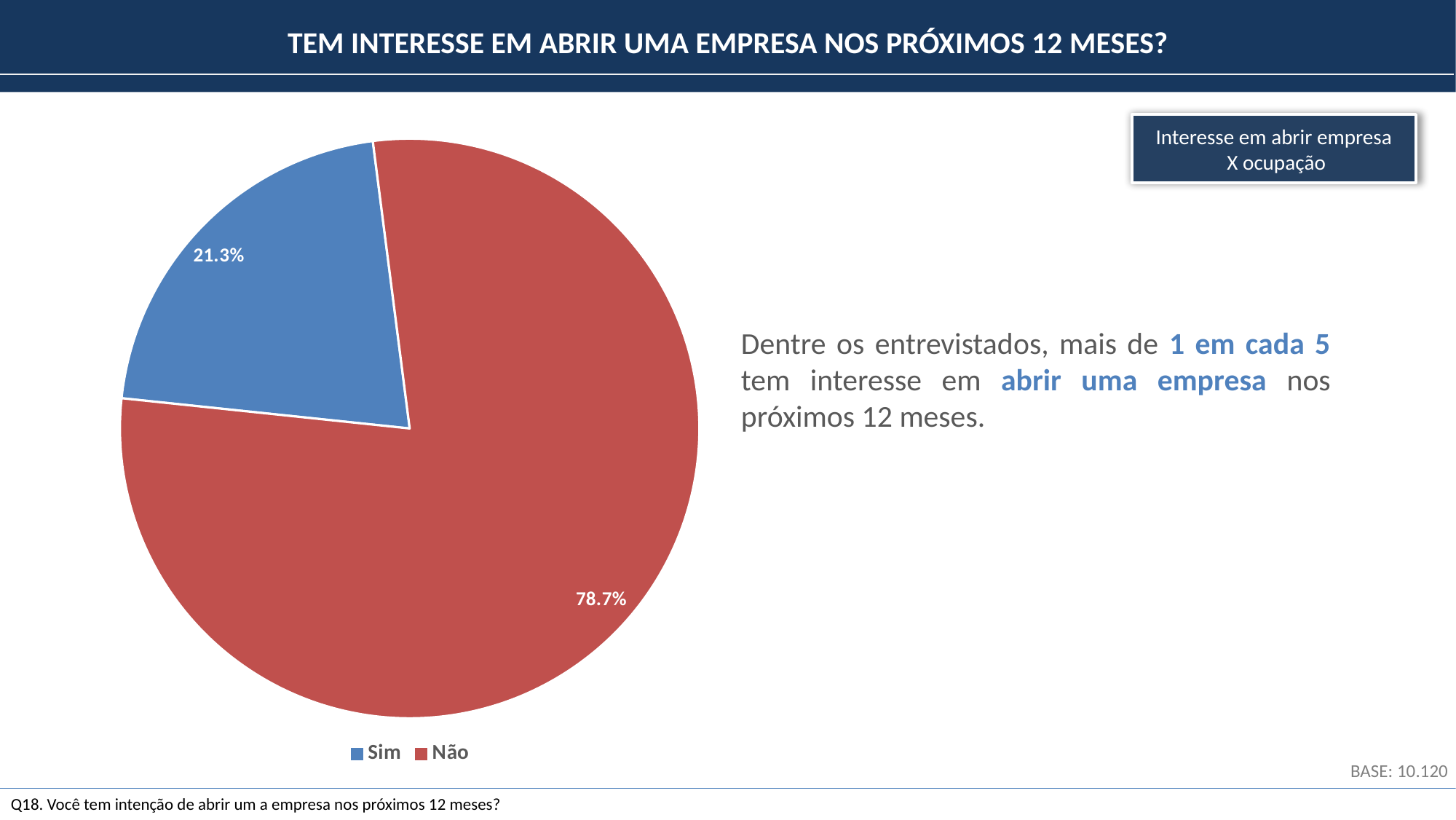
What percentage of respondents answered "Não"? 78.7% What is the difference in percentage points between the "Não" and "Sim" slices? 57.4 What colour is the "Não" slice? red What percentage of respondents answered "Sim"? 21.3% Which is larger, the share for "Sim" or the share for "Não"? Não What share of the pie does the "Sim" slice represent? 21.3% Which slice of the pie is the largest? Não What colour is the "Sim" slice? blue How many slices does the pie chart have? 2 How many entries does the legend list? 2 Which slice of the pie is the smallest? Sim What kind of chart is shown on the slide? pie chart